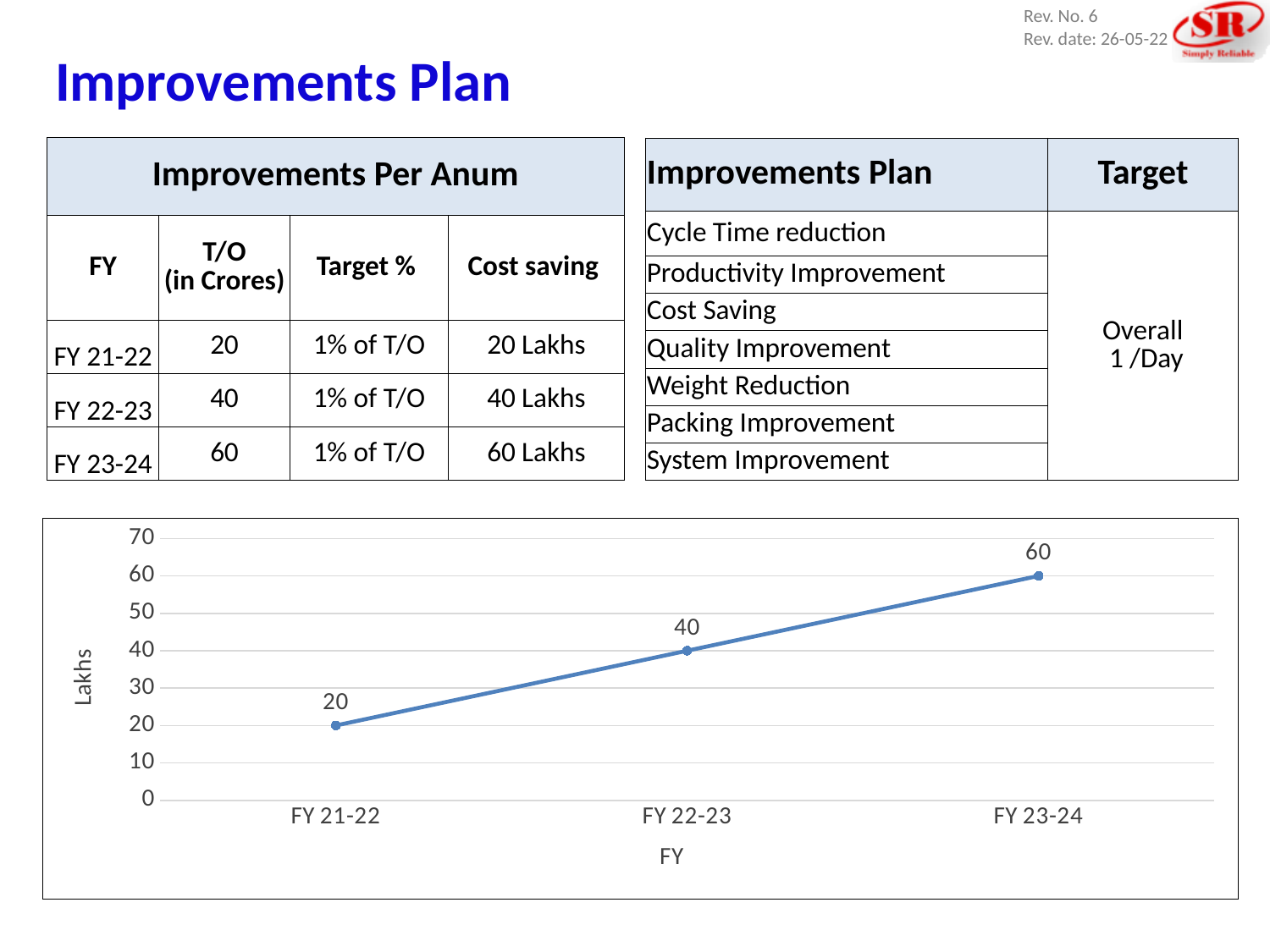
What is the label on the vertical axis of the chart? Lakhs Which is larger, the value for FY 22-23 or FY 21-22? FY 22-23 Which fiscal year has the lowest value in the chart? FY 21-22 Which fiscal year has the highest value in the chart? FY 23-24 What is the value for FY 23-24 in the chart? 60 What is the value for FY 21-22 in the chart? 20 Do the values rise or fall from FY 21-22 to FY 23-24? Rise How many fiscal years are plotted on the x axis of the chart? 3 What is the difference between the values for FY 22-23 and FY 21-22? 20 What is the value for FY 22-23 in the chart? 40 What kind of chart is shown on the slide? Line chart What is the difference between the values for FY 23-24 and FY 21-22? 40